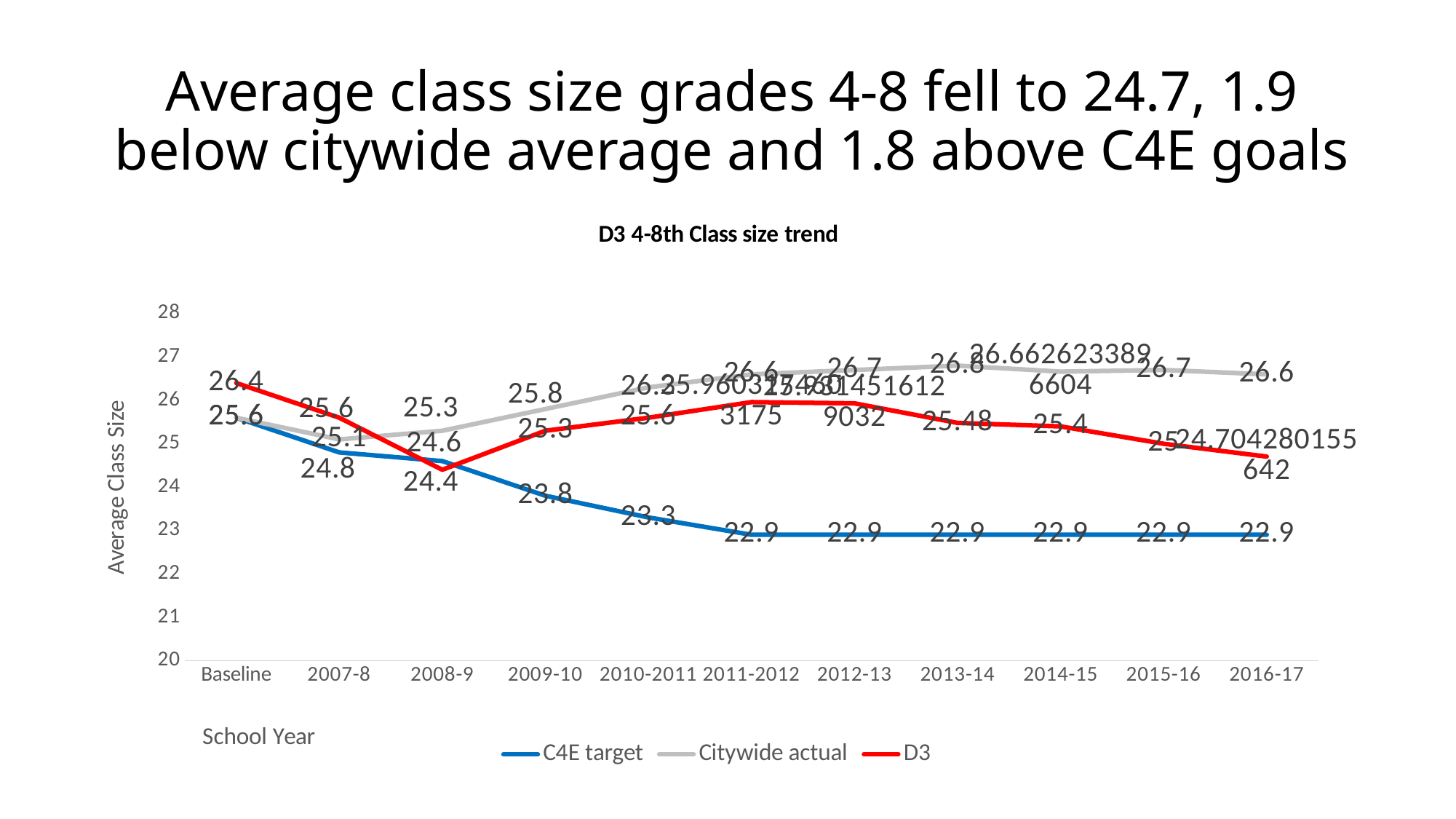
How many school years are plotted along the x axis? 11 Does the C4E target series rise or fall from Baseline to 2016-17? fall What kind of chart is shown on the slide? line chart What is the C4E target value for 2009-10? 23.8 How many series does the legend list? 3 In which school year is the D3 series at its highest? Baseline What is the difference between the D3 value at Baseline and in 2007-8? 0.8 What is the D3 value at Baseline? 26.4 What is the Citywide actual value for 2009-10? 25.8 In 2016-17, which is larger: Citywide actual or D3? Citywide actual What is the D3 value for 2014-15? 25.4 What is the C4E target value for 2016-17? 22.9